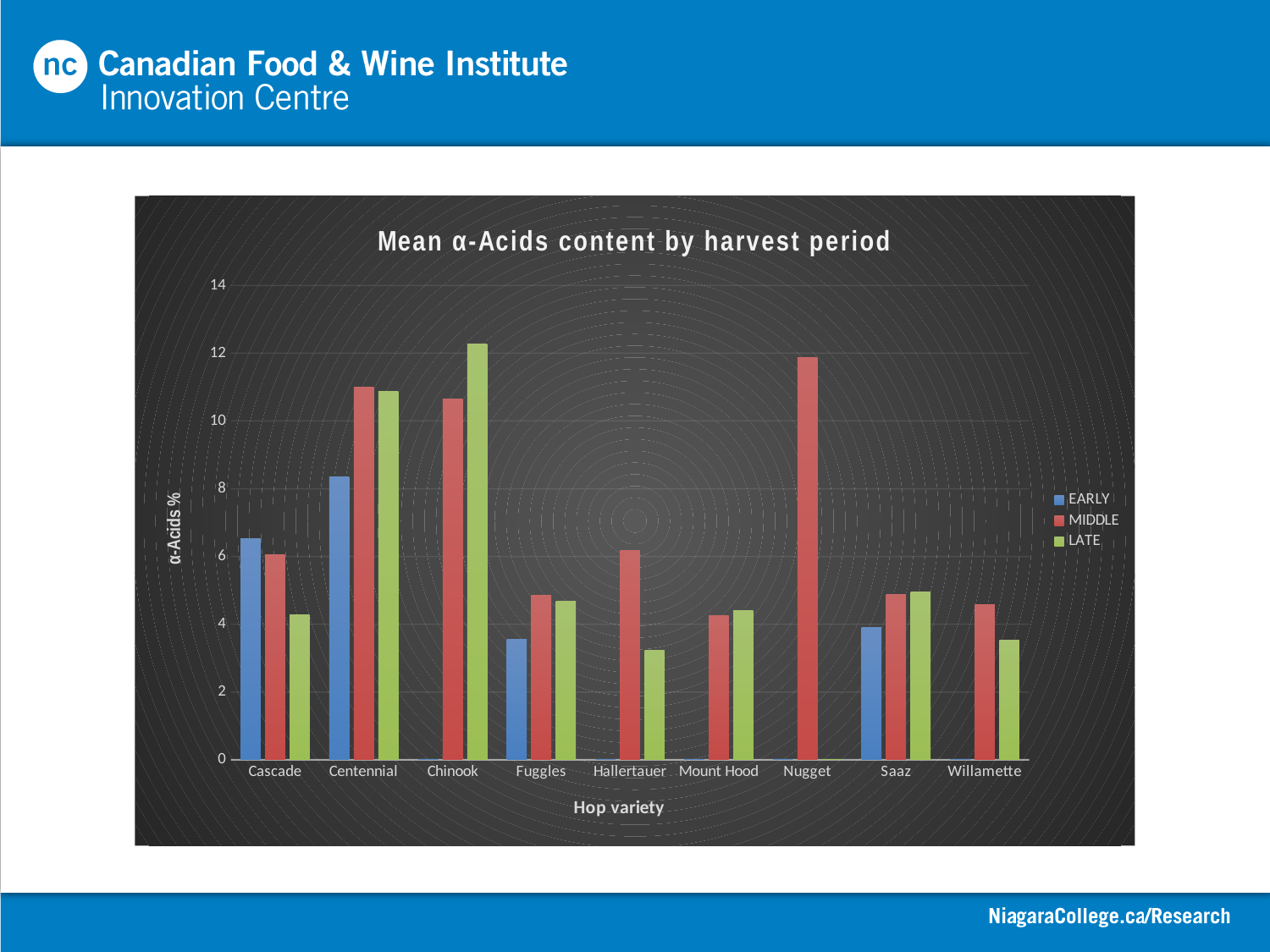
What is the title of the chart? Mean α-Acids content by harvest period How many series does the legend list? 3 For Hallertauer, which is larger: the MIDDLE or the LATE harvest value? MIDDLE Which hop variety has the highest EARLY harvest α-acids value? Centennial What kind of chart is shown on the slide? Bar chart Is the LATE harvest value for Hallertauer greater or less than 4? less How many hop varieties are shown on the x axis? 9 Which hop variety has the highest MIDDLE harvest α-acids value? Nugget Is the MIDDLE harvest value for Nugget greater or less than 10? greater For Cascade, which is larger: the EARLY or the LATE harvest value? EARLY Is the LATE harvest value for Cascade greater or less than 6? less Which hop variety has the highest LATE harvest α-acids value? Chinook